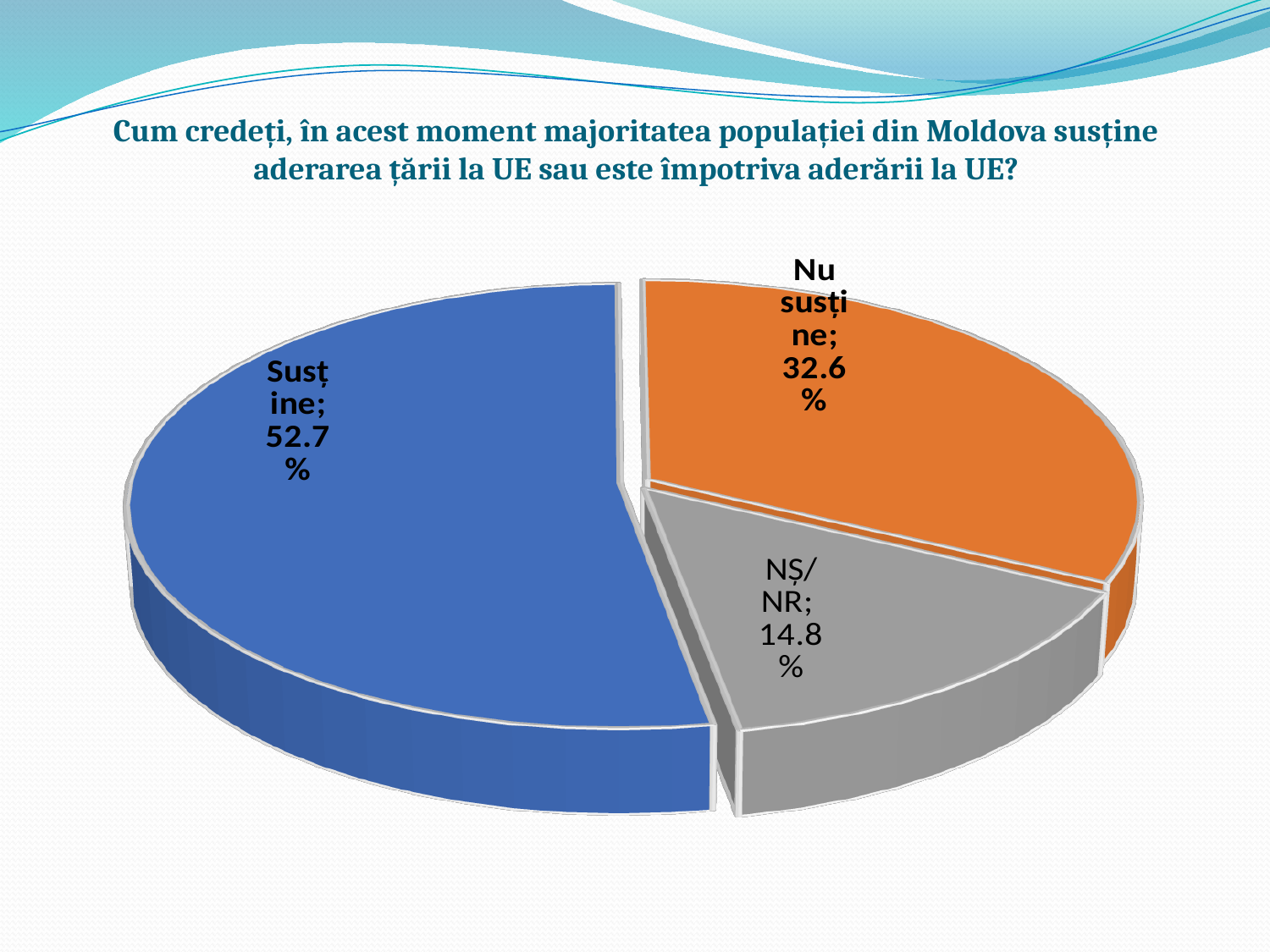
What kind of chart is shown on the slide? pie chart What colour is the "Nu susține" slice? orange What percentage is shown for the "NȘ/NR" slice? 14.8% How many slices does the pie chart have? 3 Which slice of the pie is the largest? Susține What colour is the "Susține" slice? blue Which is larger, the "Nu susține" slice or the "NȘ/NR" slice? Nu susține Which slice of the pie is the smallest? NȘ/NR What percentage is shown for the "Nu susține" slice? 32.6% What is the difference in percentage points between the "Nu susține" and "NȘ/NR" slices? 17.8 What is the difference in percentage points between the "Susține" and "Nu susține" slices? 20.1 What percentage is shown for the "Susține" slice? 52.7%